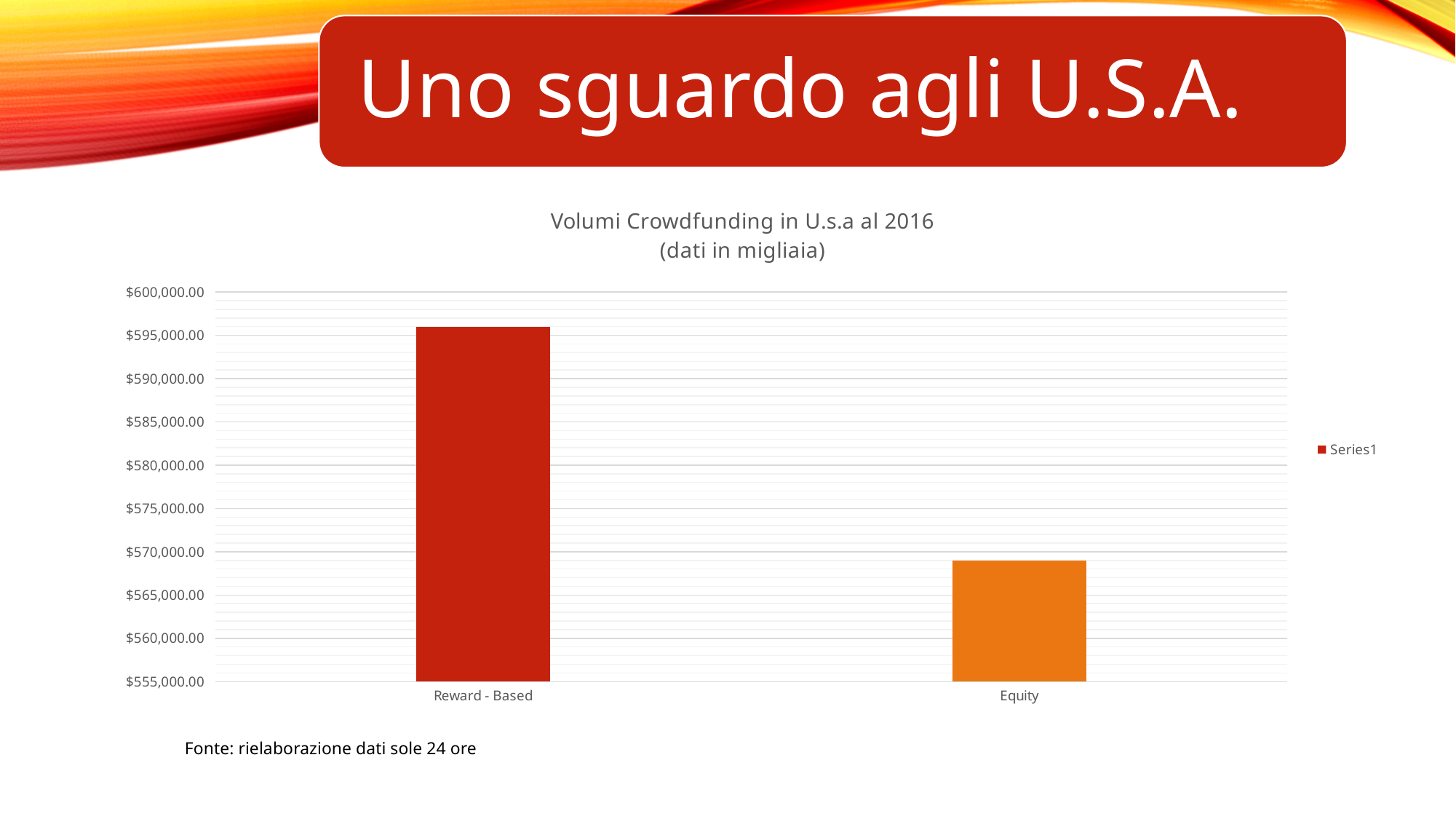
Which category has the lowest value? Equity Which category has the highest value? Reward - Based What kind of chart is shown on the slide? Bar chart Which is larger, the value for Reward - Based or the value for Equity? Reward - Based Is the value for Reward - Based greater or less than $600,000.00? less How many series does the legend list? 1 What is the title of the chart? Volumi Crowdfunding in U.s.a al 2016 (dati in migliaia) Is the value for Equity greater or less than $565,000.00? greater Is the value for Equity greater or less than $575,000.00? less How many categories are plotted in the chart? 2 What is the name of the series shown in the legend? Series1